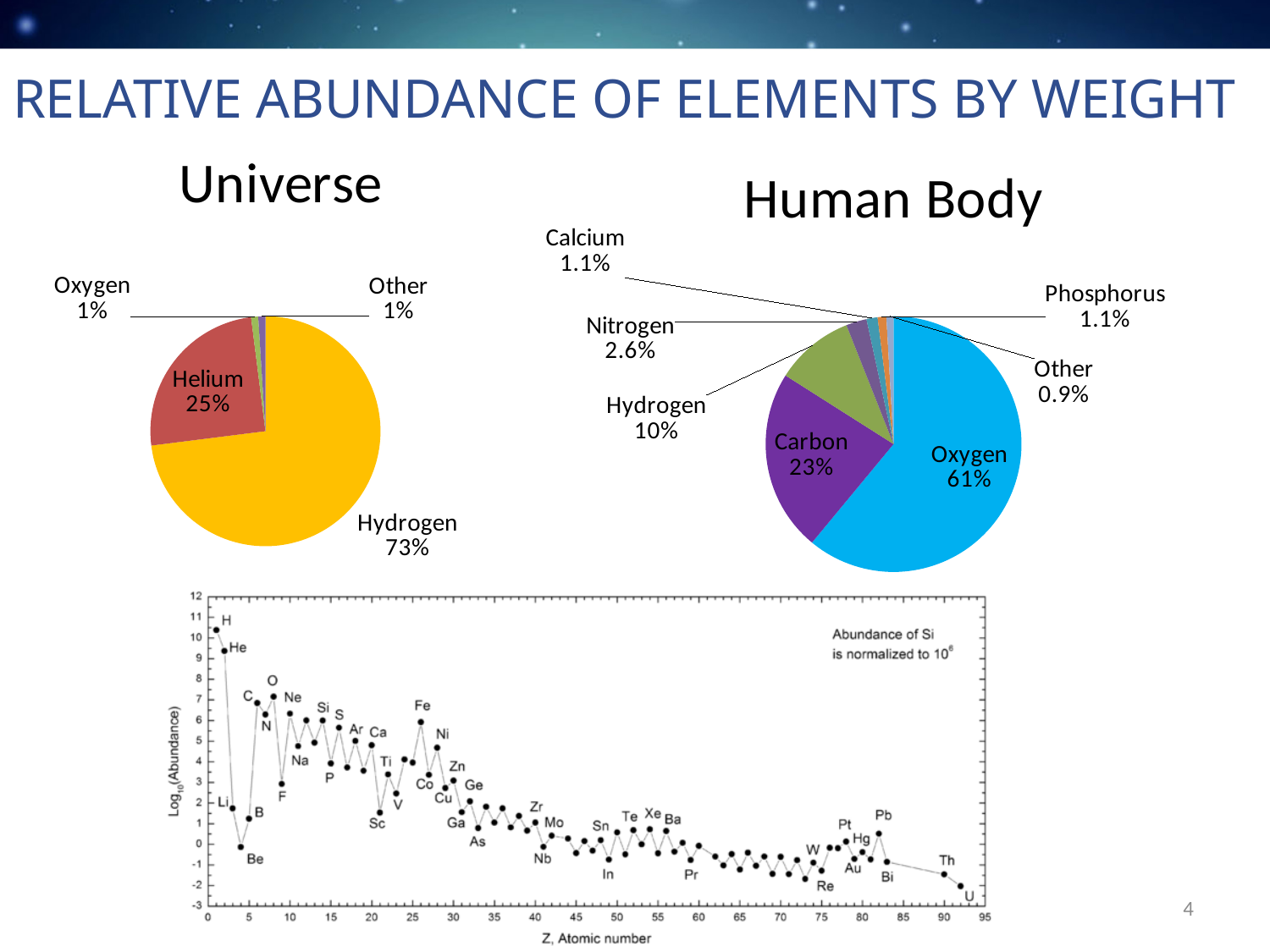
In the bottom chart of Log10(Abundance) versus atomic number, do the values generally rise or fall as atomic number increases? Fall In the Human Body pie chart, what is the difference in percentage points between Oxygen and Carbon? 38 percentage points How many slices does the Human Body pie chart have? 7 In the Universe pie chart, what percentage is Helium? 25% In the Human Body pie chart, which element has the smallest slice? Other (0.9%) In the Human Body pie chart, what percentage is Nitrogen? 2.6% In the Human Body pie chart, what percentage is Oxygen? 61% In the Universe pie chart, which element has the largest slice? Hydrogen What kind of chart is the Universe chart? Pie chart In the bottom chart of Log10(Abundance) versus atomic number, is the value for H greater or less than 10? greater In the Human Body pie chart, which is larger, Carbon or Hydrogen? Carbon In the Universe pie chart, what share of elements by weight is Hydrogen? 73%